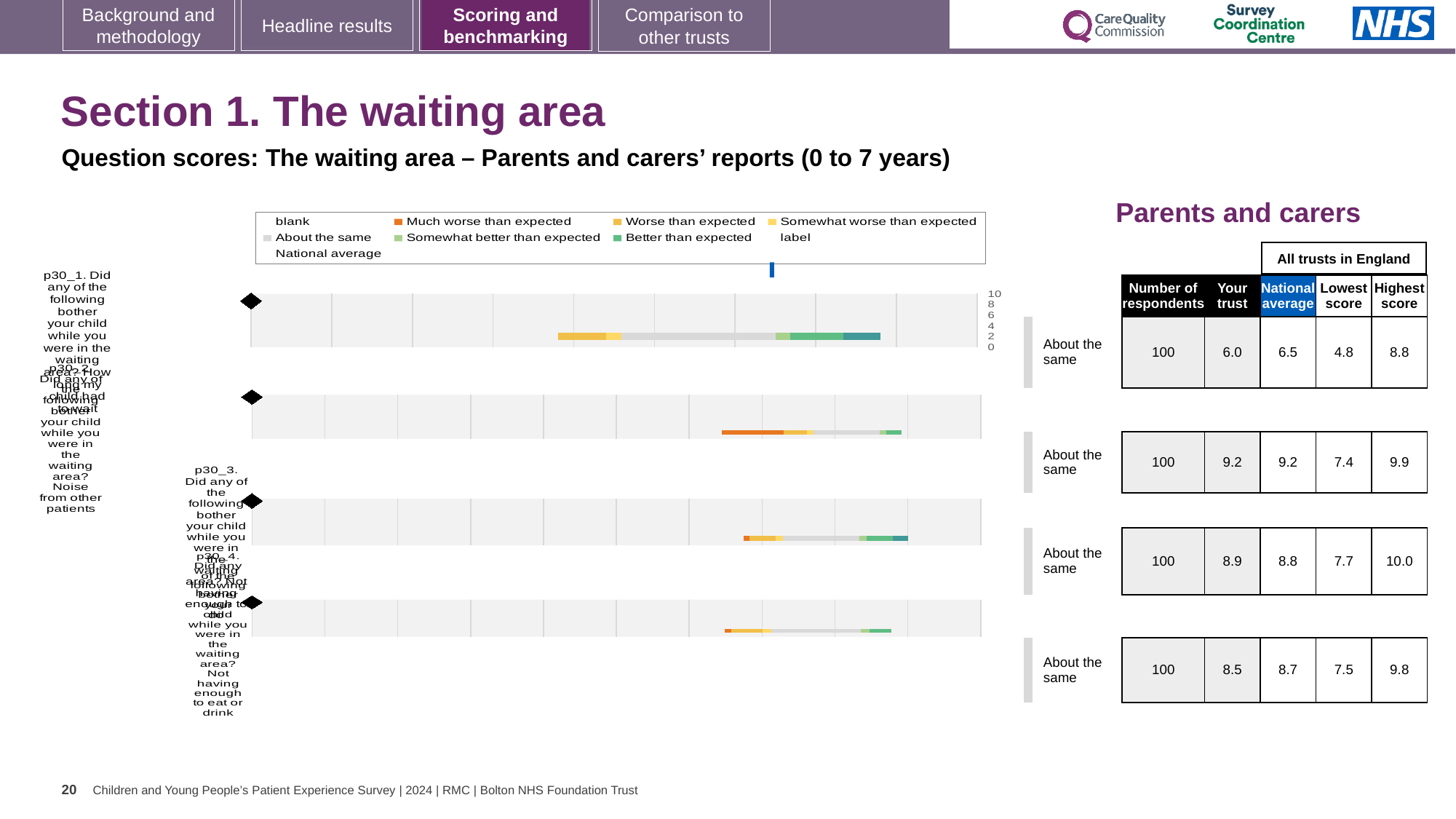
What does the dark blue marker in the chart legend represent? National average What is the question code of the first bar in the chart? p30_1 What benchmark category is shown beside each of the four bars? About the same What kind of chart is shown on the slide? bar chart In the table next to the chart, what is the Highest score for the third question row? 10.0 What is the highest tick value shown on the chart's score axis? 10 In the table next to the chart, what is the National average for the second question row? 9.2 In the table next to the chart, what is the 'Your trust' score for the first question row? 6.0 How many entries does the chart legend list? 9 What is the question code of the last bar in the chart? p30_4 How many question rows (bars) are plotted in the chart? 4